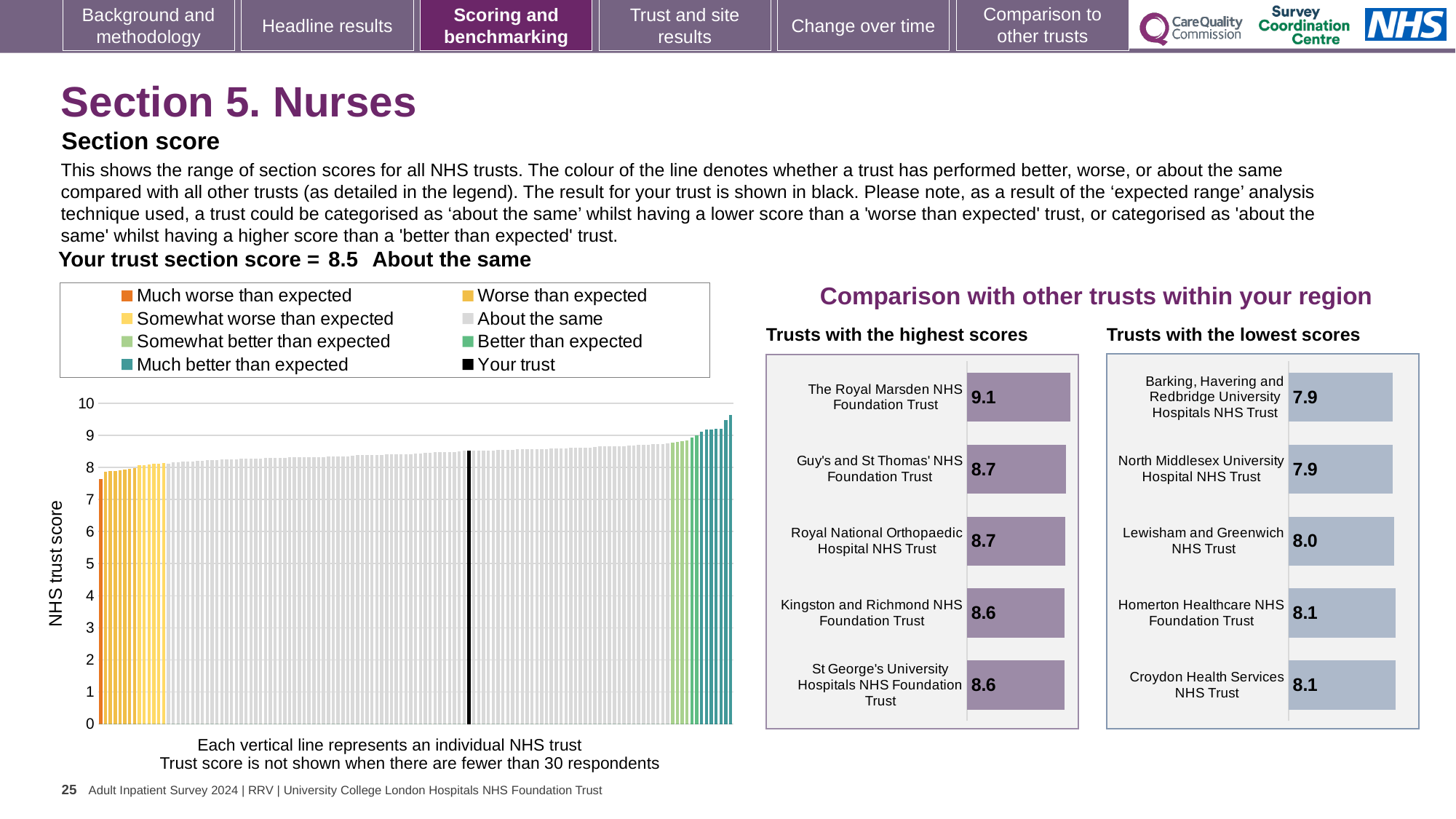
What kind of chart is the 'Trusts with the lowest scores' chart? Bar chart In the 'Trusts with the highest scores' chart, what is the score for The Royal Marsden NHS Foundation Trust? 9.1 How many trusts are shown in the 'Trusts with the highest scores' chart? 5 In the 'Trusts with the highest scores' chart, what is the difference between the scores of The Royal Marsden NHS Foundation Trust and Guy's and St Thomas' NHS Foundation Trust? 0.4 In the 'Trusts with the highest scores' chart, which has the larger score: The Royal Marsden NHS Foundation Trust or Kingston and Richmond NHS Foundation Trust? The Royal Marsden NHS Foundation Trust In the large NHS trust score chart on the left, what is the section score for your trust? 8.5 In the 'Trusts with the lowest scores' chart, which has the larger score: Lewisham and Greenwich NHS Trust or Homerton Healthcare NHS Foundation Trust? Homerton Healthcare NHS Foundation Trust In the large NHS trust score chart on the left, is the value of the highest-scoring trust greater or less than 9? greater In the 'Trusts with the highest scores' chart, which trust has the highest score? The Royal Marsden NHS Foundation Trust In the 'Trusts with the lowest scores' chart, what is the score for Homerton Healthcare NHS Foundation Trust? 8.1 In the 'Trusts with the lowest scores' chart, what is the difference between the scores of Croydon Health Services NHS Trust and Barking, Havering and Redbridge University Hospitals NHS Trust? 0.2 In the 'Trusts with the lowest scores' chart, what is the score for Lewisham and Greenwich NHS Trust? 8.0